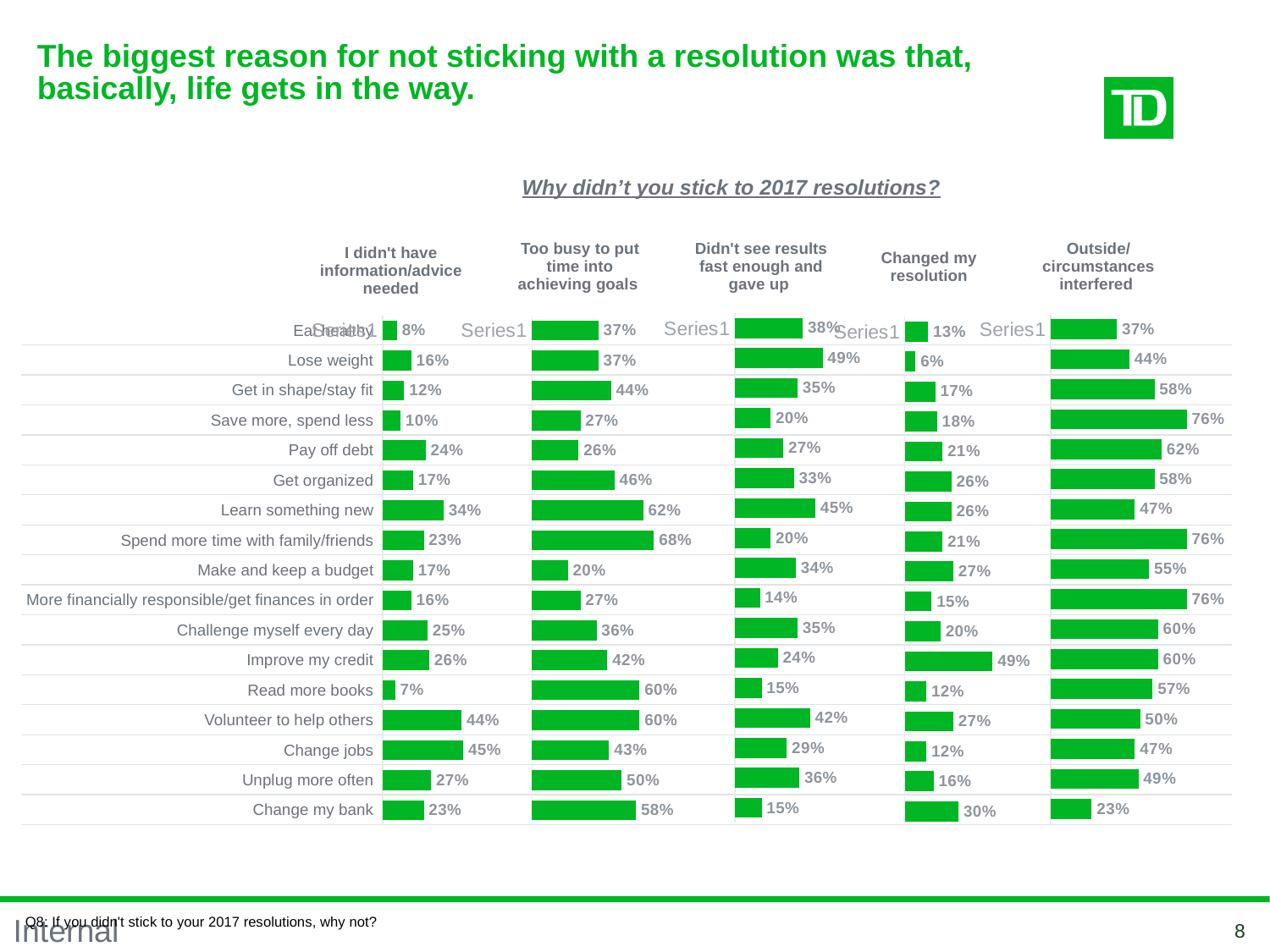
In the "I didn't have information/advice needed" chart, which category has the lowest value? Read more books In the "Changed my resolution" chart, what is the value for Improve my credit? 49% In the "Changed my resolution" chart, which category has the highest value? Improve my credit In the "Outside/circumstances interfered" chart, what is the value for Save more, spend less? 76% For Save more, spend less, what is the difference between the "Outside/circumstances interfered" value and the "Changed my resolution" value? 58 percentage points In the "Too busy to put time into achieving goals" chart, which category has the highest value? Spend more time with family/friends In the "Outside/circumstances interfered" chart, which category has the lowest value? Change my bank In the "Didn't see results fast enough and gave up" chart, what is the value for Lose weight? 49% For Read more books, which is larger: the value in the "Too busy to put time into achieving goals" chart or the value in the "Didn't see results fast enough and gave up" chart? Too busy to put time into achieving goals What is the title shown above the charts? Why didn't you stick to 2017 resolutions? What kind of chart is used to show the reasons for not sticking to 2017 resolutions? Bar chart In the "Too busy to put time into achieving goals" chart, what is the value for Spend more time with family/friends? 68%